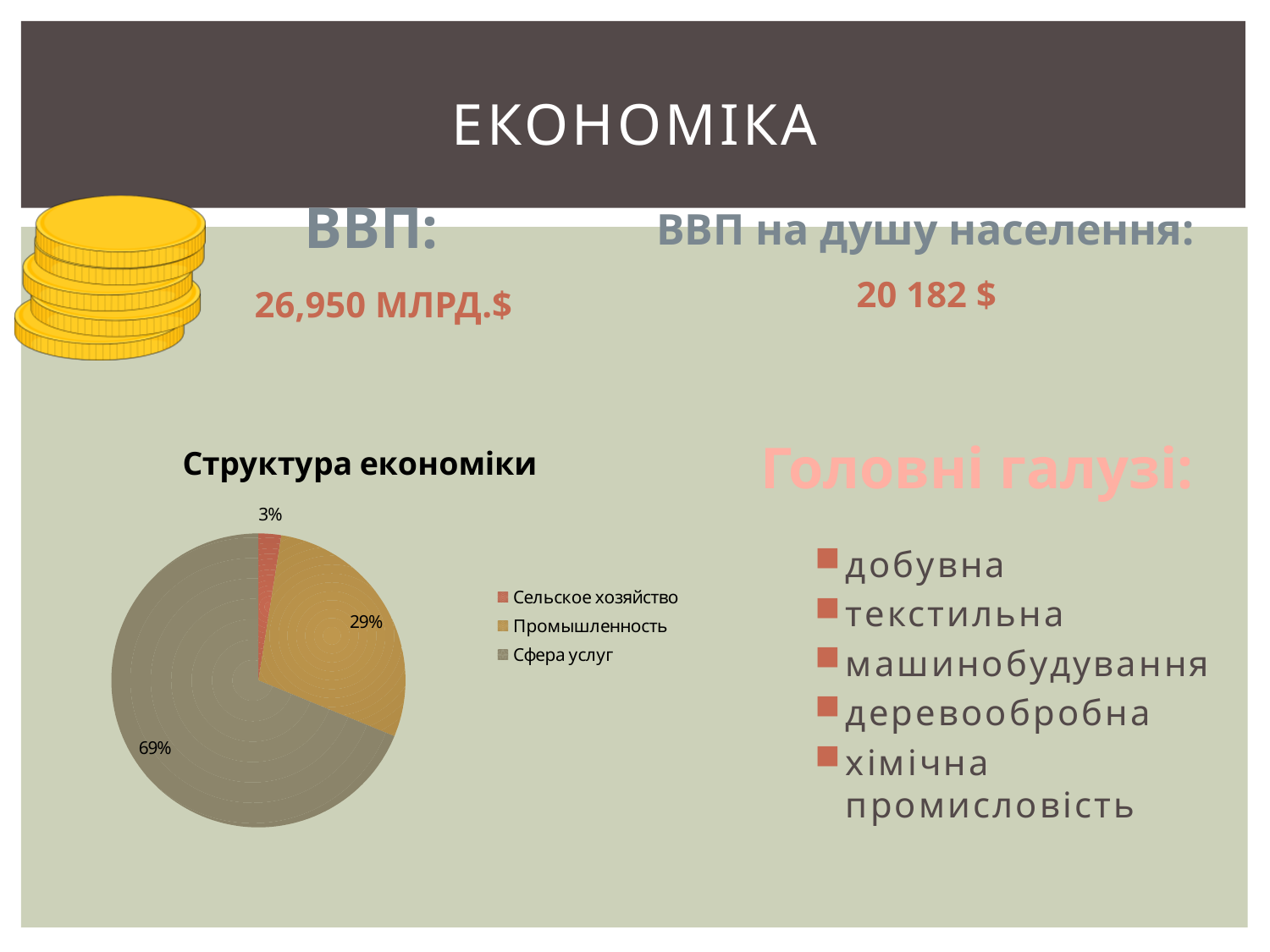
What share of the pie does Сельское хозяйство have? 3% Which category has the largest slice of the pie? Сфера услуг Which category has the smallest slice of the pie? Сельское хозяйство How many entries does the legend of the pie chart list? 3 What share of the pie does Промышленность have? 29% Which legend entry is shown in red? Сельское хозяйство Which is larger, the share for Промышленность or the share for Сельское хозяйство? Промышленность What is the title of the chart on the slide? Структура економіки What is the difference in percentage points between the Сфера услуг slice and the Промышленность slice? 40 What kind of chart is shown on the slide? pie chart How many slices does the pie chart have? 3 What share of the pie does Сфера услуг have? 69%